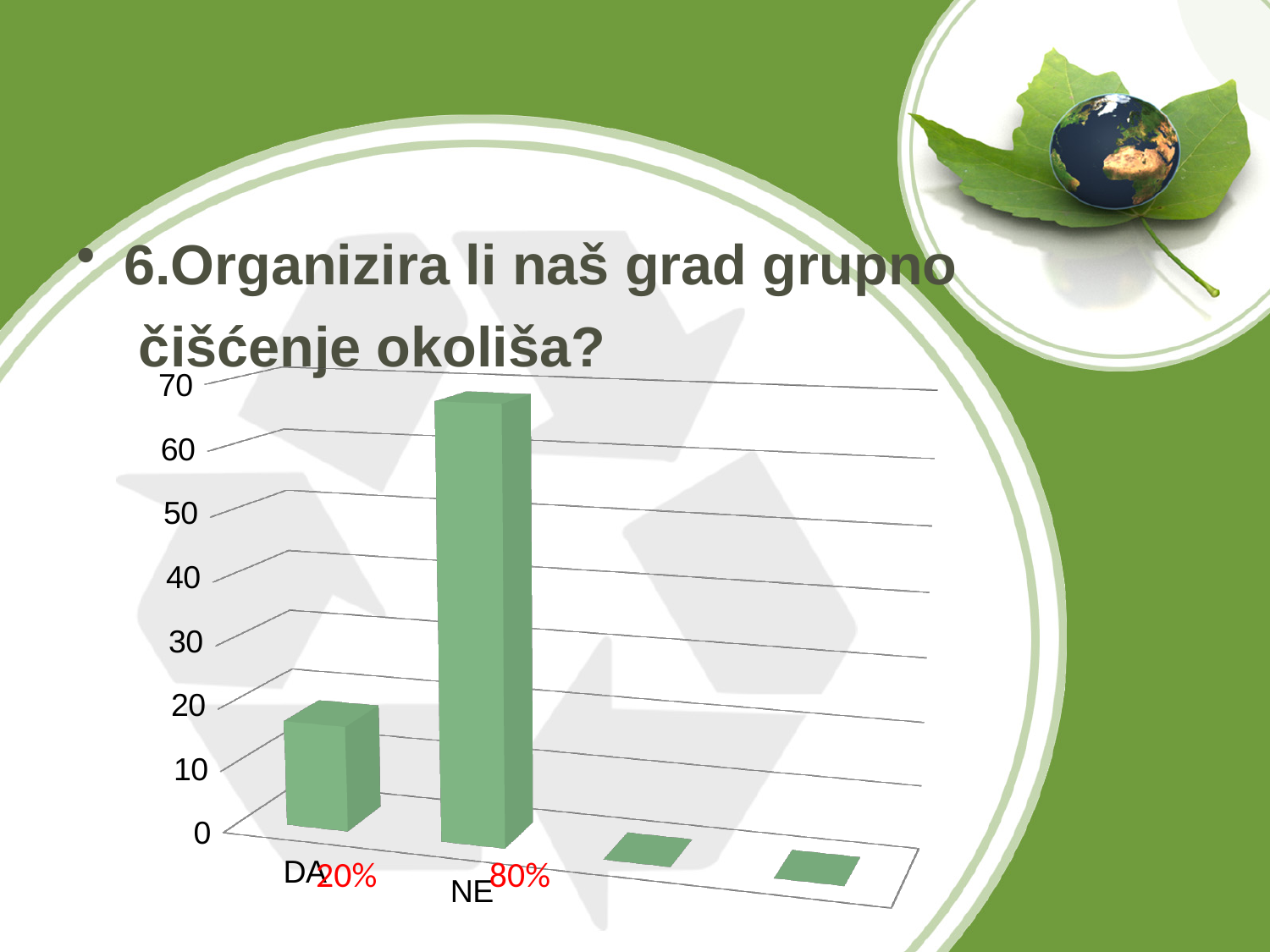
What kind of chart is shown on the slide? bar chart Is the bar for NE taller or shorter than the bar for DA? taller Is the value for DA greater or less than 20? less Which of the two labelled categories has the shorter bar? DA Which category has the tallest bar, DA or NE? NE What percentage is written in red next to the DA category? 20% What is the highest value shown on the vertical axis? 70 What question does the chart on the slide answer? 6.Organizira li naš grad grupno čišćenje okoliša? Is the value for DA greater or less than 10? greater Is the value for NE greater or less than 60? greater What percentage is written in red next to the NE category? 80%